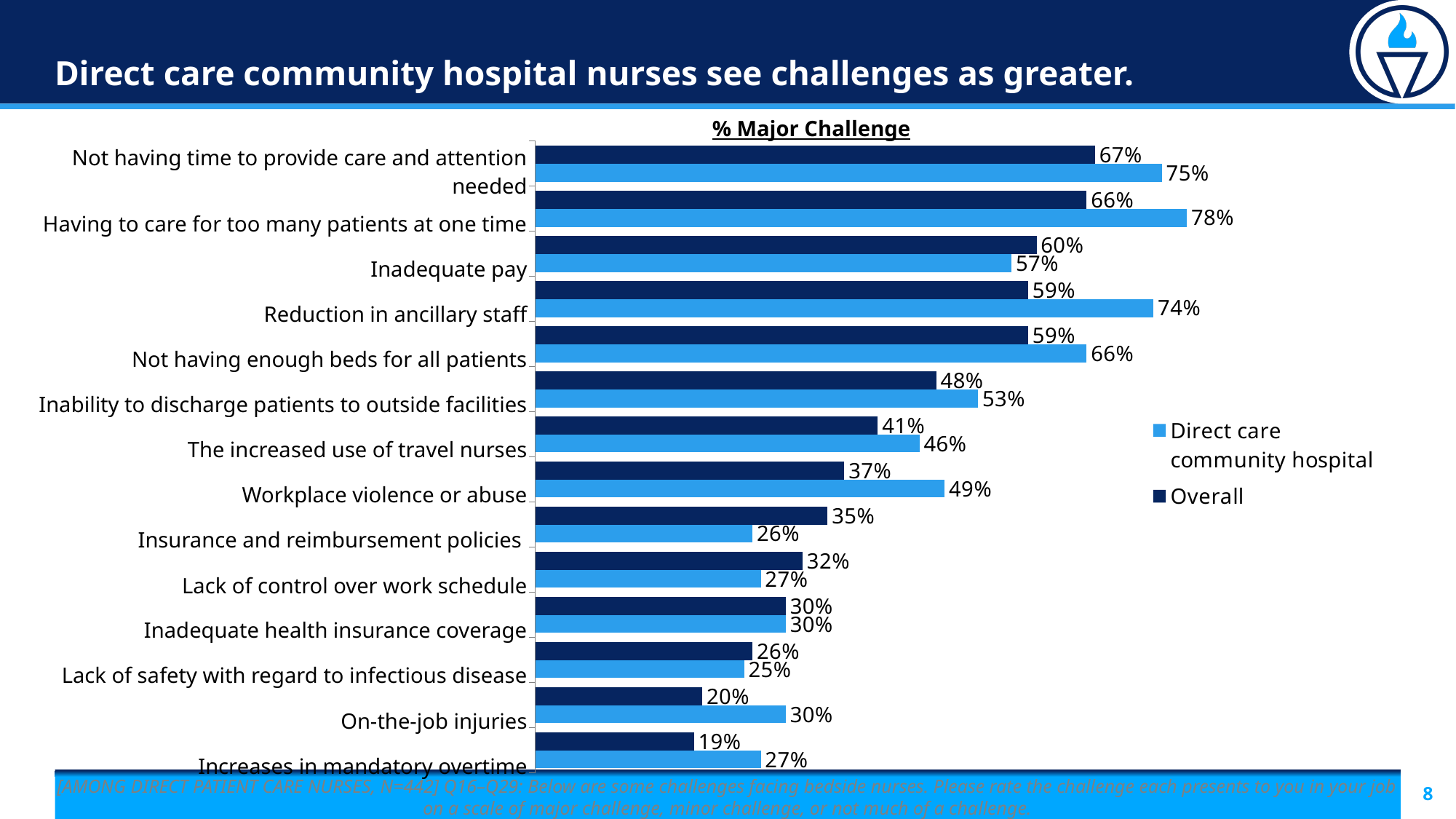
What is the Direct care community hospital value for 'Having to care for too many patients at one time'? 78% How many series does the legend list? 2 What is the title of the chart? % Major Challenge For 'Inadequate pay', which is larger: the Overall value or the Direct care community hospital value? Overall Which category has the highest Direct care community hospital value? Having to care for too many patients at one time How many challenge categories are plotted in the chart? 14 What is the Direct care community hospital value for 'Reduction in ancillary staff'? 74% Which category has the lowest Overall value? Increases in mandatory overtime What is the Overall value for 'Workplace violence or abuse'? 37% What is the difference between the Direct care community hospital and Overall values for 'Reduction in ancillary staff'? 15% What type of chart is shown on the slide? Bar chart For 'Insurance and reimbursement policies', which is larger: the Overall value or the Direct care community hospital value? Overall